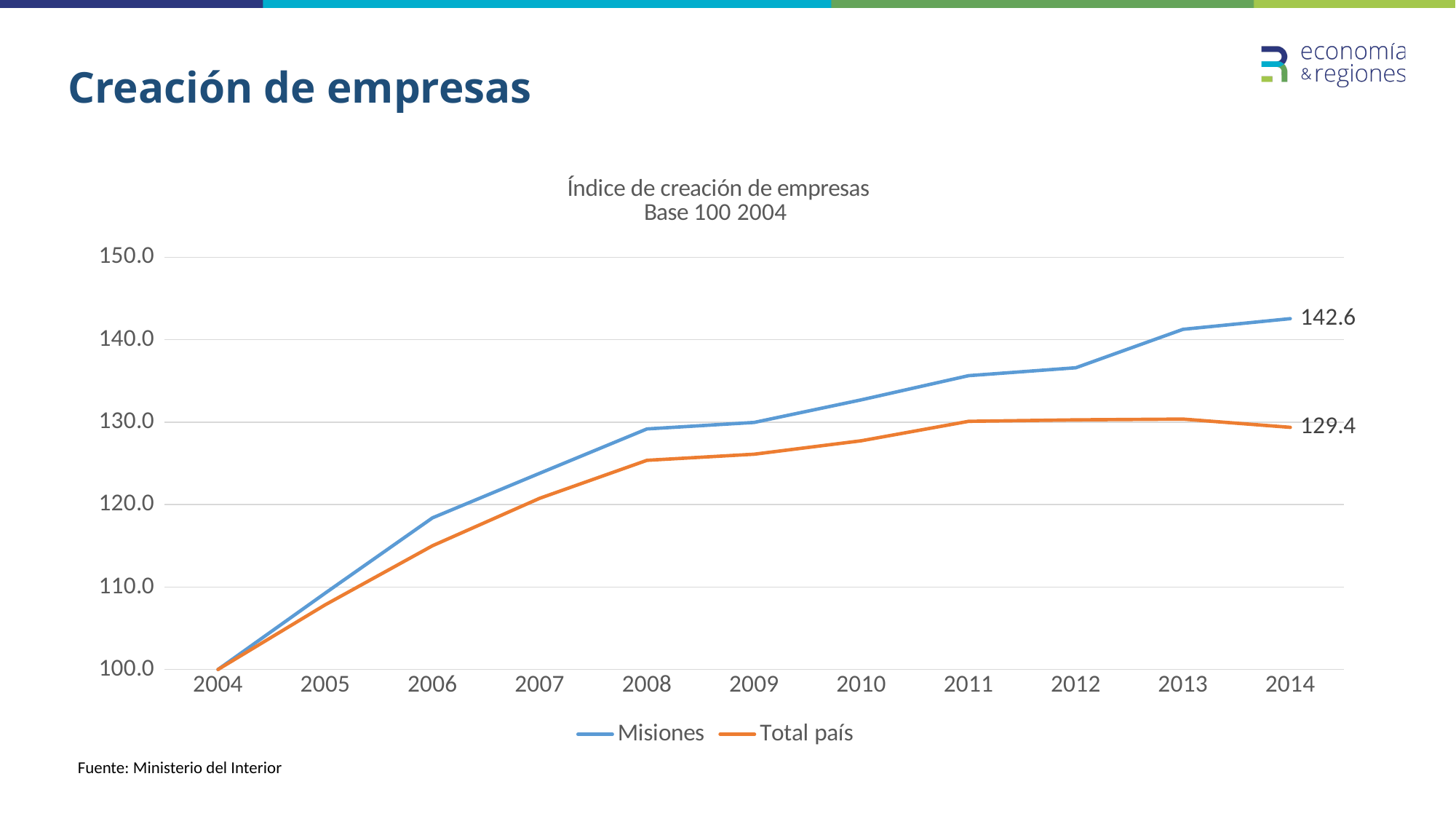
What is the title of the chart? Índice de creación de empresas Base 100 2004 What is the value for Misiones in 2014? 142.6 Which series has the higher value in 2014, Misiones or Total país? Misiones What is the difference between the Misiones and Total país values in 2014? 13.2 How many years are shown on the x axis? 11 What kind of chart is shown on the slide? Line chart Is the value for Misiones in 2013 greater or less than 140? greater Is the value for Total país in 2006 greater or less than 120? less Is the value for Misiones in 2008 greater or less than 120? greater How many series does the legend list? 2 Does the Misiones series rise or fall from 2004 to 2014? Rise What is the value for Total país in 2014? 129.4